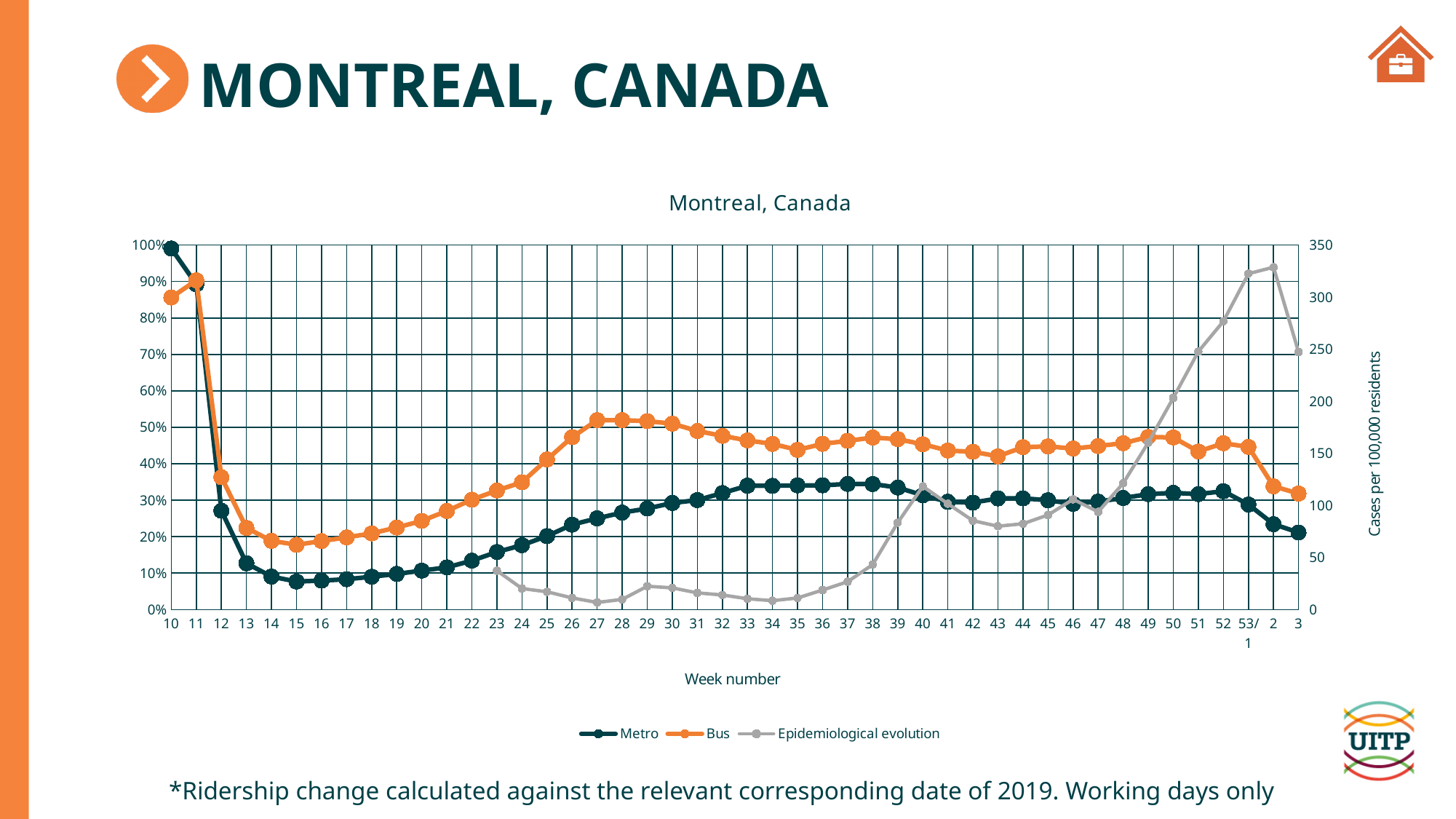
What kind of chart is shown on the slide? line chart Is the Epidemiological evolution value at week 2 greater or less than 300? greater Is the Bus value at week 27 greater or less than 50%? greater At week 27, which is larger, the Bus value or the Metro value? Bus What is the label of the right-hand vertical axis? Cases per 100,000 residents How many series does the legend list? 3 At which week is the Epidemiological evolution series highest? 2 What is the title of the chart? Montreal, Canada At which week is the Metro series highest? 10 Is the Metro value at week 15 greater or less than 10%? less Does the Metro series rise or fall from week 10 to week 15? fall